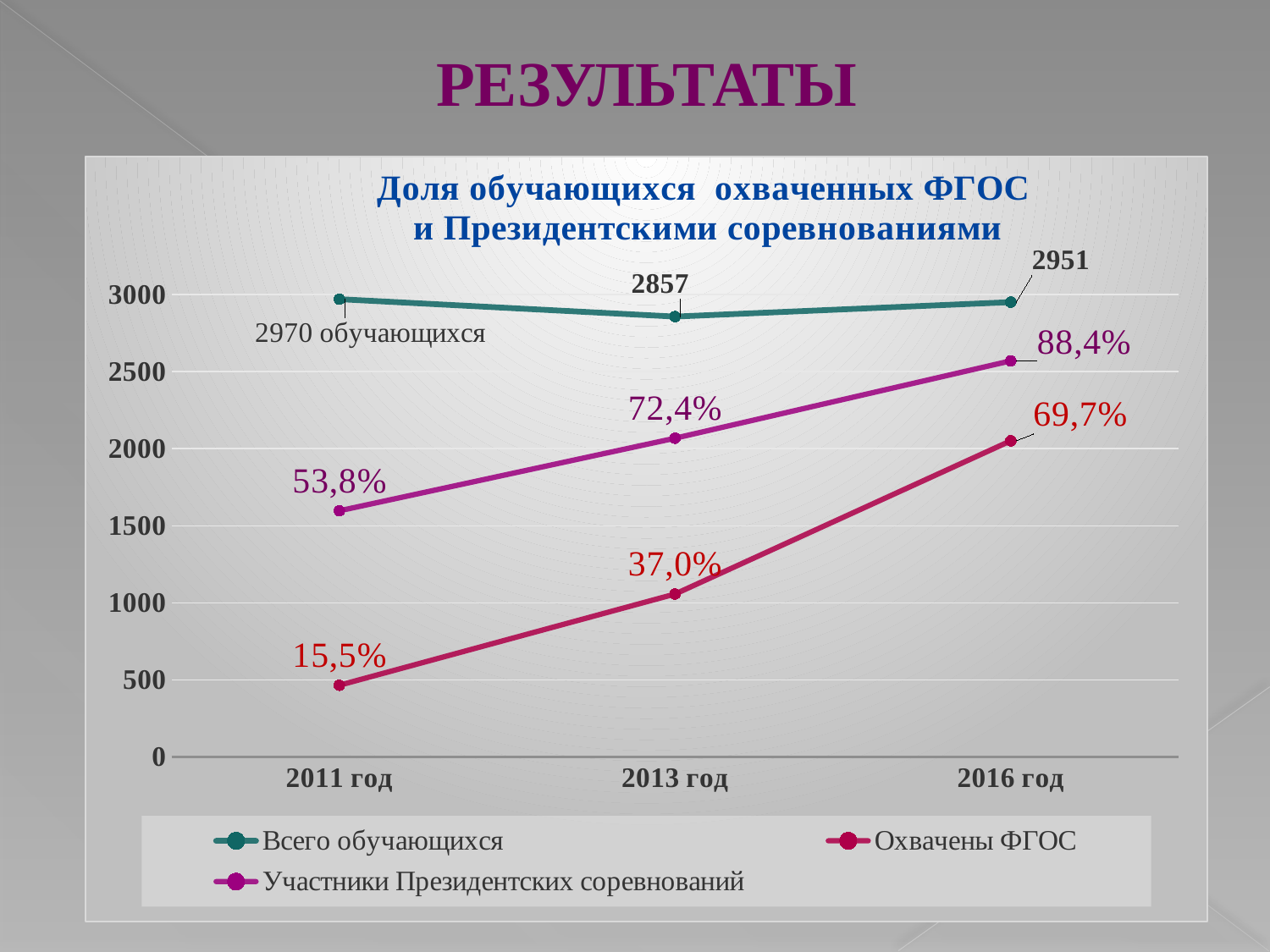
In which year is the Всего обучающихся value lowest? 2013 год What is the data label for Всего обучающихся in 2016 год? 2951 Is the plotted value for Участники Президентских соревнований in 2016 год greater or less than 2500? greater How many series does the legend list? 3 What is the difference between the Всего обучающихся values in 2011 год and 2013 год? 113 What is the data label for Всего обучающихся in 2013 год? 2857 How many years are shown on the x axis? 3 What kind of chart is shown on the slide? line chart What is the data label for Участники Президентских соревнований in 2016 год? 88,4% What is the data label for Охвачены ФГОС in 2011 год? 15,5% Does the Охвачены ФГОС line rise or fall from 2011 год to 2016 год? rise What is the data label for Участники Президентских соревнований in 2013 год? 72,4%